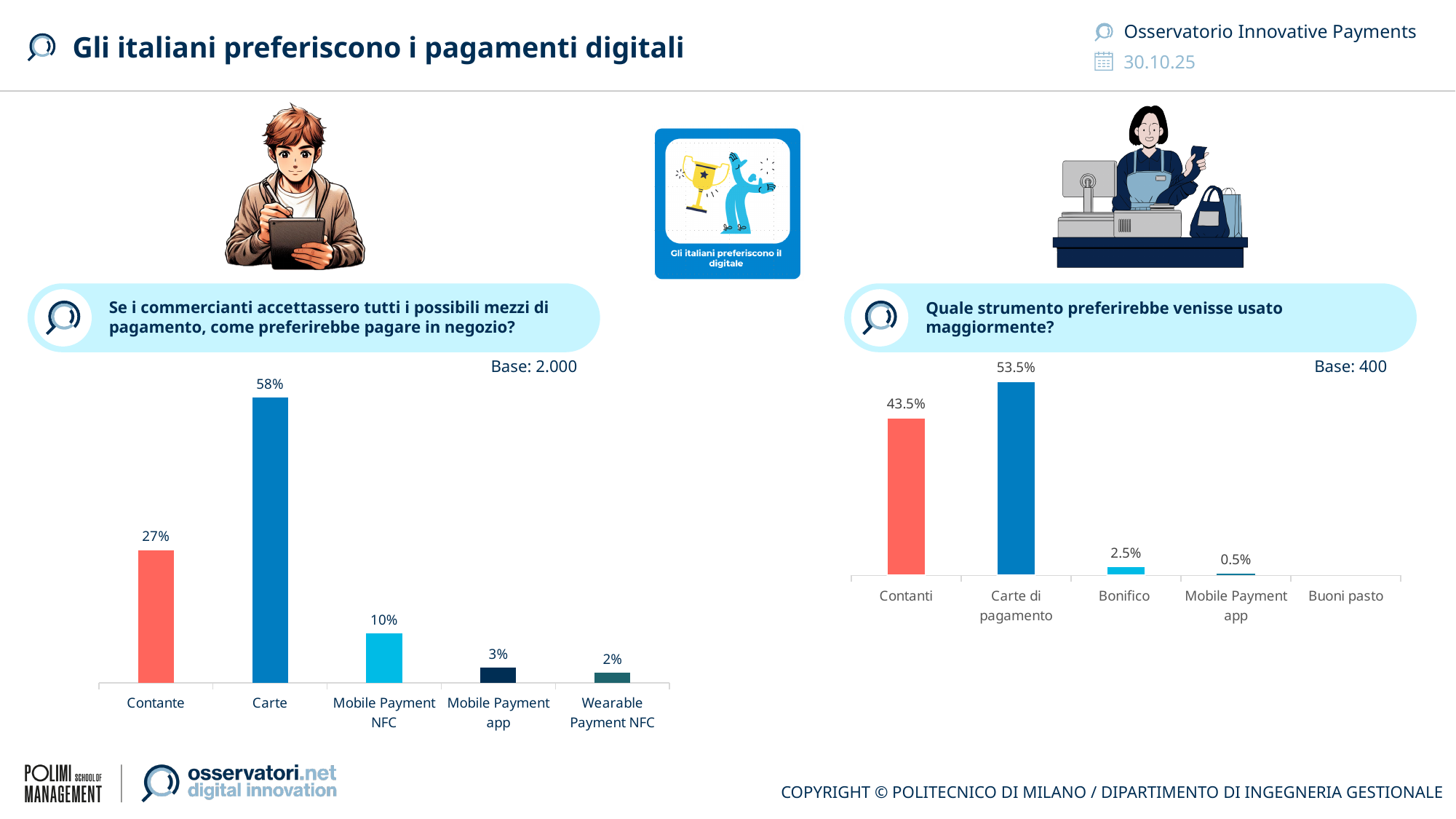
What is the base (sample size) stated for the right chart? 400 In the left chart (how would you prefer to pay in store), what is the value for Contante? 27% In the right chart (which instrument would you prefer to be used most), what is the difference between Carte di pagamento and Contanti? 10% In the right chart (which instrument would you prefer to be used most), which category has the highest value? Carte di pagamento In the left chart (how would you prefer to pay in store), which is larger: Mobile Payment NFC or Mobile Payment app? Mobile Payment NFC In the left chart (how would you prefer to pay in store), what is the value for Carte? 58% In the left chart (how would you prefer to pay in store), how many categories are shown? 5 In the left chart (how would you prefer to pay in store), which category has the lowest value? Wearable Payment NFC In the left chart (how would you prefer to pay in store), what is the difference between Carte and Contante? 31% In the right chart (which instrument would you prefer to be used most), what is the value for Carte di pagamento? 53.5% What kind of chart is the right chart (which instrument would you prefer to be used most)? bar chart In the right chart (which instrument would you prefer to be used most), what is the value for Bonifico? 2.5%